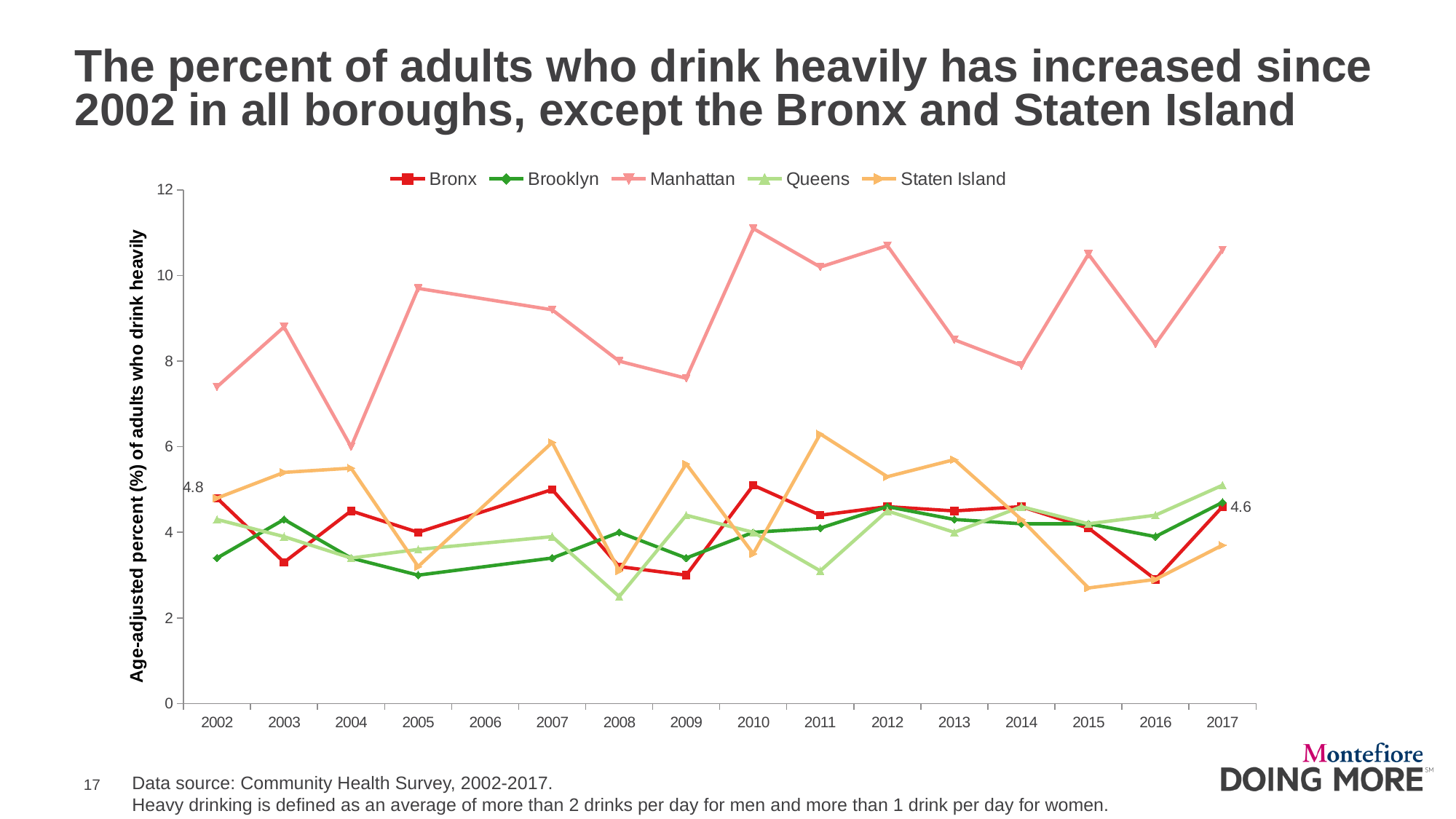
Is the value for Manhattan in 2010 greater or less than 10? greater Is the value for Queens in 2008 greater or less than 4? less What is the labeled value for the Bronx in 2017? 4.6 How many series does the legend list? 5 Which borough has the highest value in 2010? Manhattan What is the labeled value for the Bronx in 2002? 4.8 What kind of chart is shown on the slide? Line chart Which borough is listed first in the legend? Bronx Is the value for Manhattan in 2004 greater or less than 8? less Which is larger for the Bronx: the 2002 value or the 2017 value? 2002 How many years are shown on the x axis? 16 By how much did the Bronx value change between 2002 (4.8) and 2017 (4.6)? 0.2